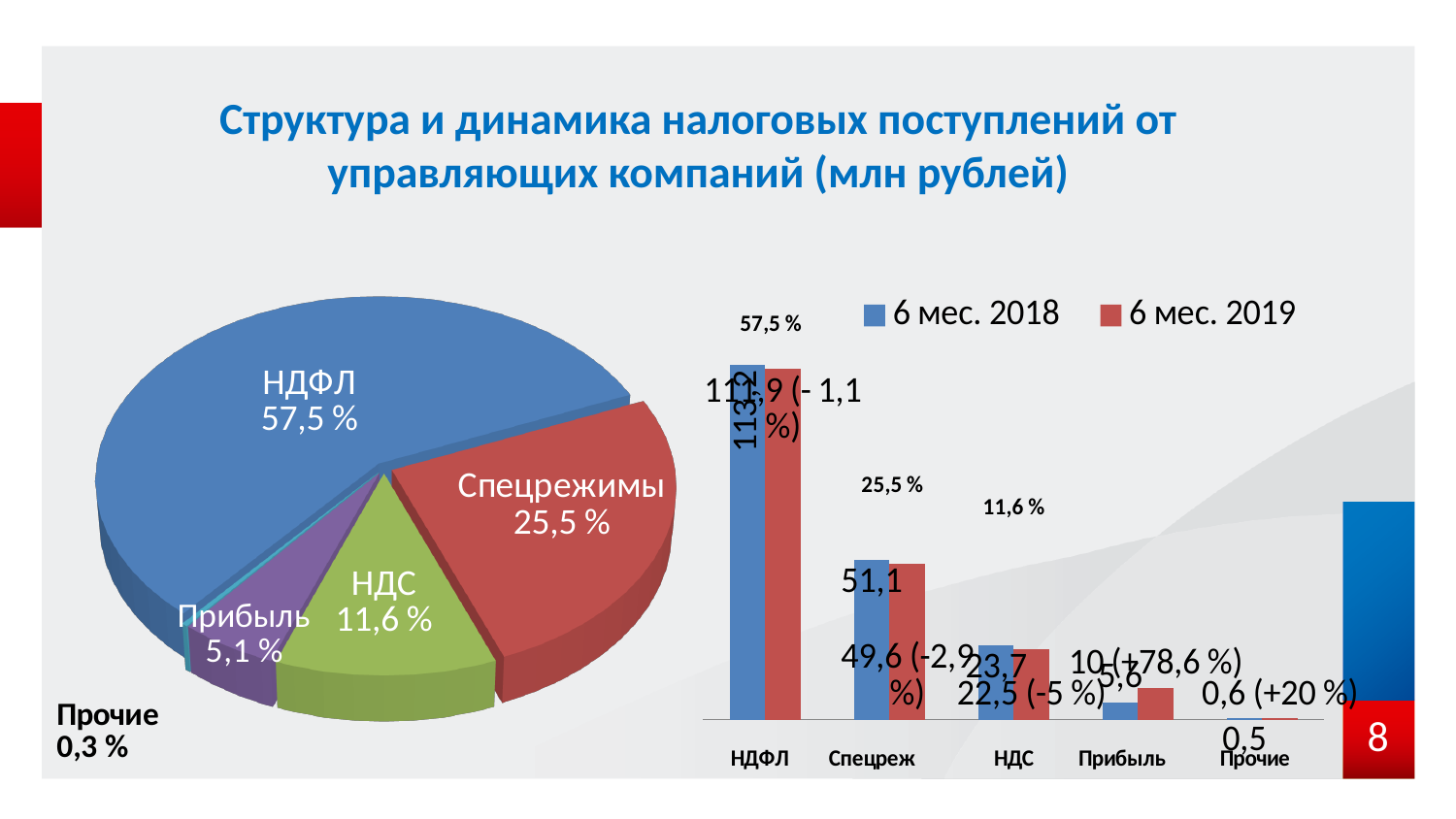
On the bar chart on the right, what is the difference between the 6 мес. 2018 and 6 мес. 2019 values for Спецреж? 1,5 On the pie chart on the left, how many slices are there? 5 What kind of chart is shown on the left of the slide? Pie chart On the bar chart on the right, which is larger for Прибыль: the 6 мес. 2018 value or the 6 мес. 2019 value? 6 мес. 2019 On the pie chart on the left, what share does НДФЛ have? 57,5 % On the pie chart on the left, what share does Спецрежимы have? 25,5 % On the bar chart on the right, how many categories are shown on the x axis? 5 On the bar chart on the right, what is the value for НДС for 6 мес. 2019? 22,5 On the bar chart on the right, what is the value for Спецреж for 6 мес. 2018? 51,1 On the bar chart on the right, how many series does the legend list? 2 On the pie chart on the left, which category has the largest slice? НДФЛ On the pie chart on the left, which category has the smallest slice? Прочие